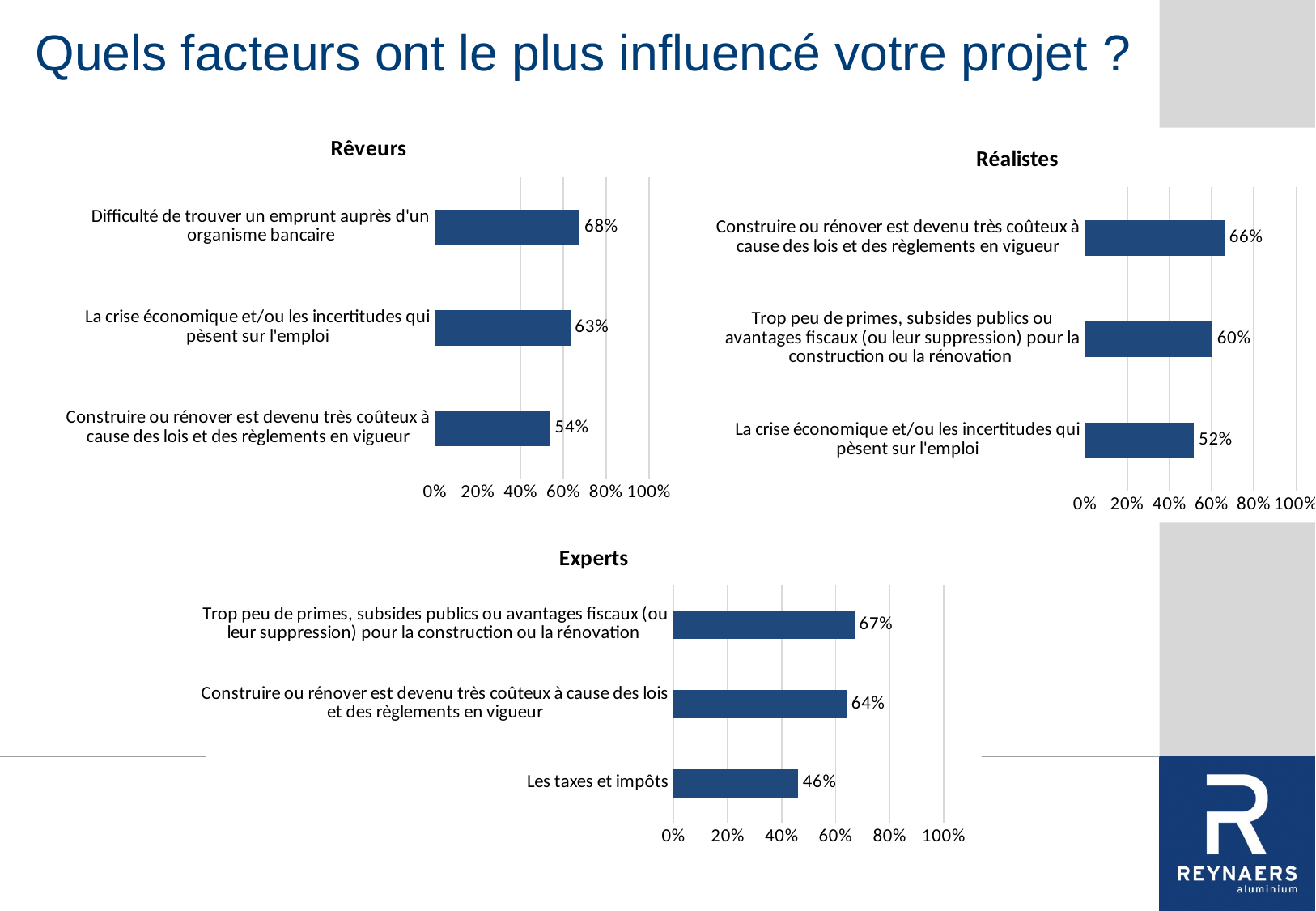
In the 'Experts' chart, what is the difference between the values for 'Trop peu de primes, subsides publics ou avantages fiscaux (ou leur suppression) pour la construction ou la rénovation' and 'Les taxes et impôts'? 21% In the 'Rêveurs' chart, what is the difference between the values for 'Difficulté de trouver un emprunt auprès d'un organisme bancaire' and 'La crise économique et/ou les incertitudes qui pèsent sur l'emploi'? 5% In the 'Rêveurs' chart, what is the value for 'Difficulté de trouver un emprunt auprès d'un organisme bancaire'? 68% Which is larger: the value for 'La crise économique et/ou les incertitudes qui pèsent sur l'emploi' in the 'Rêveurs' chart or in the 'Réalistes' chart? Rêveurs In the 'Réalistes' chart, which category has the highest value? Construire ou rénover est devenu très coûteux à cause des lois et des règlements en vigueur In the 'Rêveurs' chart, which category has the lowest value? Construire ou rénover est devenu très coûteux à cause des lois et des règlements en vigueur How many categories are shown in the 'Experts' chart? 3 In the 'Réalistes' chart, what is the value for 'Trop peu de primes, subsides publics ou avantages fiscaux (ou leur suppression) pour la construction ou la rénovation'? 60% How many charts are shown on the slide? 3 In the 'Experts' chart, what is the value for 'Les taxes et impôts'? 46% What kind of chart is the 'Rêveurs' chart? Bar chart In the 'Réalistes' chart, is the value for 'La crise économique et/ou les incertitudes qui pèsent sur l'emploi' greater or less than 60%? less